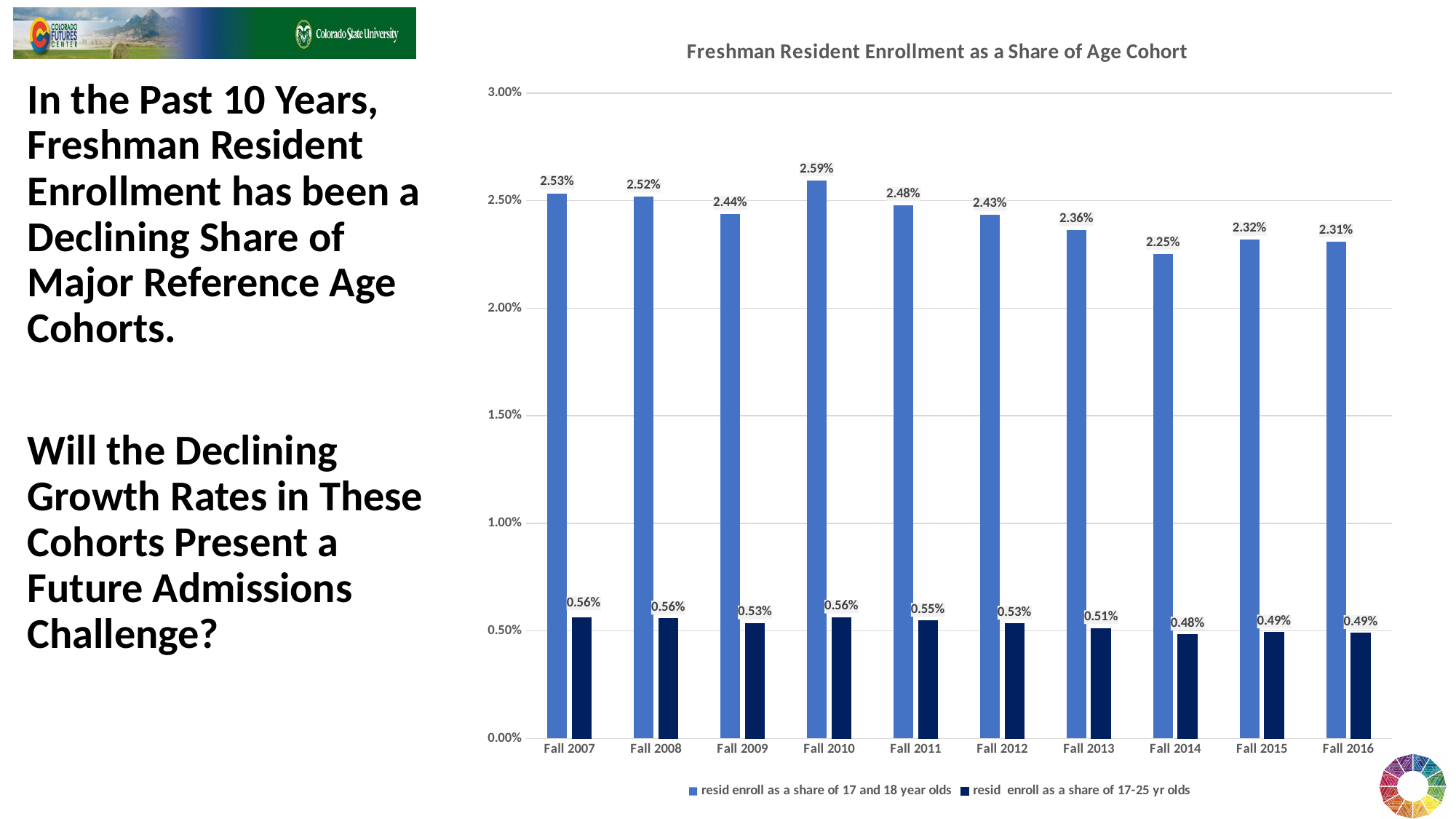
How many years are shown on the x axis of the chart? 10 What is the difference between the 'resid enroll as a share of 17 and 18 year olds' values for Fall 2007 and Fall 2016? 0.22% Is the value for 'resid enroll as a share of 17 and 18 year olds' in Fall 2009 greater or less than 2.50%? less What is the value for 'resid enroll as a share of 17-25 yr olds' in Fall 2014? 0.48% Which year has the lowest value for 'resid enroll as a share of 17 and 18 year olds'? Fall 2014 Which is larger: the 'resid enroll as a share of 17 and 18 year olds' value for Fall 2011 or for Fall 2013? Fall 2011 What is the title of the chart? Freshman Resident Enrollment as a Share of Age Cohort What is the value for 'resid enroll as a share of 17 and 18 year olds' in Fall 2010? 2.59% What kind of chart is shown on the slide? bar chart Do the values for 'resid enroll as a share of 17 and 18 year olds' generally rise or fall from Fall 2007 to Fall 2016? fall Which year has the highest value for 'resid enroll as a share of 17 and 18 year olds'? Fall 2010 How many series does the legend list? 2